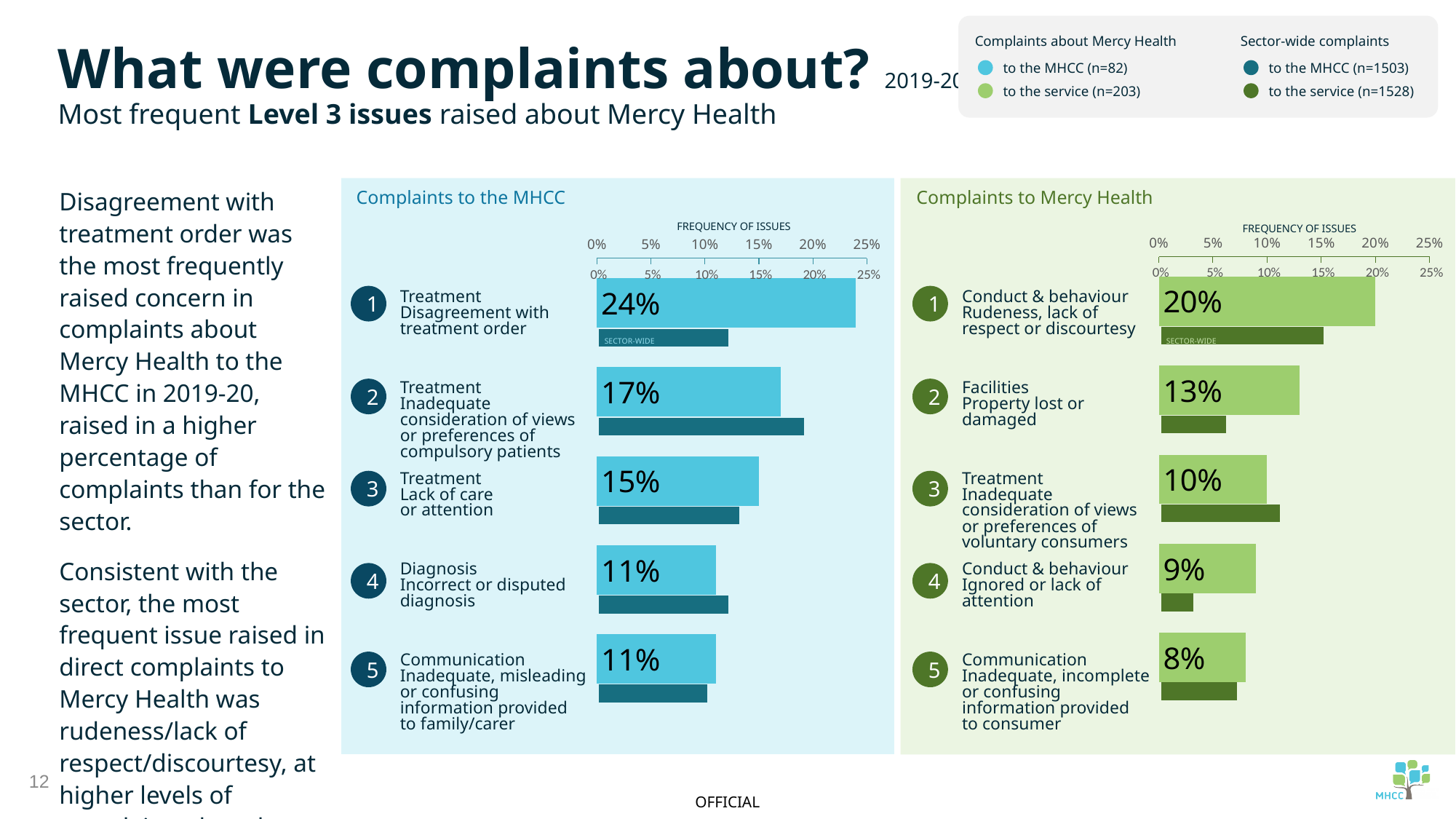
In the 'Complaints to the MHCC' chart, what percentage of complaints about Mercy Health concerned disagreement with treatment order? 24% In the 'Complaints to the MHCC' chart, is the sector-wide value for 'Inadequate consideration of views or preferences of compulsory patients' greater or less than 15%? greater In the 'Complaints to Mercy Health' chart, what is the difference between the values for 'Property lost or damaged' and 'Ignored or lack of attention'? 4% In the 'Complaints to Mercy Health' chart, is the sector-wide value for 'Property lost or damaged' greater or less than 10%? less What type of chart is used in the 'Complaints to the MHCC' panel? Bar chart In the 'Complaints to the MHCC' chart, which issue has the highest frequency for Mercy Health? Treatment – Disagreement with treatment order Which is larger: the Mercy Health value for 'Inadequate consideration of views or preferences of compulsory patients' in the 'Complaints to the MHCC' chart, or the value for 'Inadequate consideration of views or preferences of voluntary consumers' in the 'Complaints to Mercy Health' chart? Complaints to the MHCC (17%) In the 'Complaints to the MHCC' chart, what is the difference between the Mercy Health values for 'Disagreement with treatment order' and 'Lack of care or attention'? 9% How many issues are listed in the 'Complaints to Mercy Health' chart? 5 In the 'Complaints to Mercy Health' chart, what is the value for 'Facilities – Property lost or damaged'? 13% In the 'Complaints to Mercy Health' chart, which issue has the lowest frequency? Communication – Inadequate, incomplete or confusing information provided to consumer In the 'Complaints to Mercy Health' chart, what percentage of complaints concerned rudeness, lack of respect or discourtesy? 20%